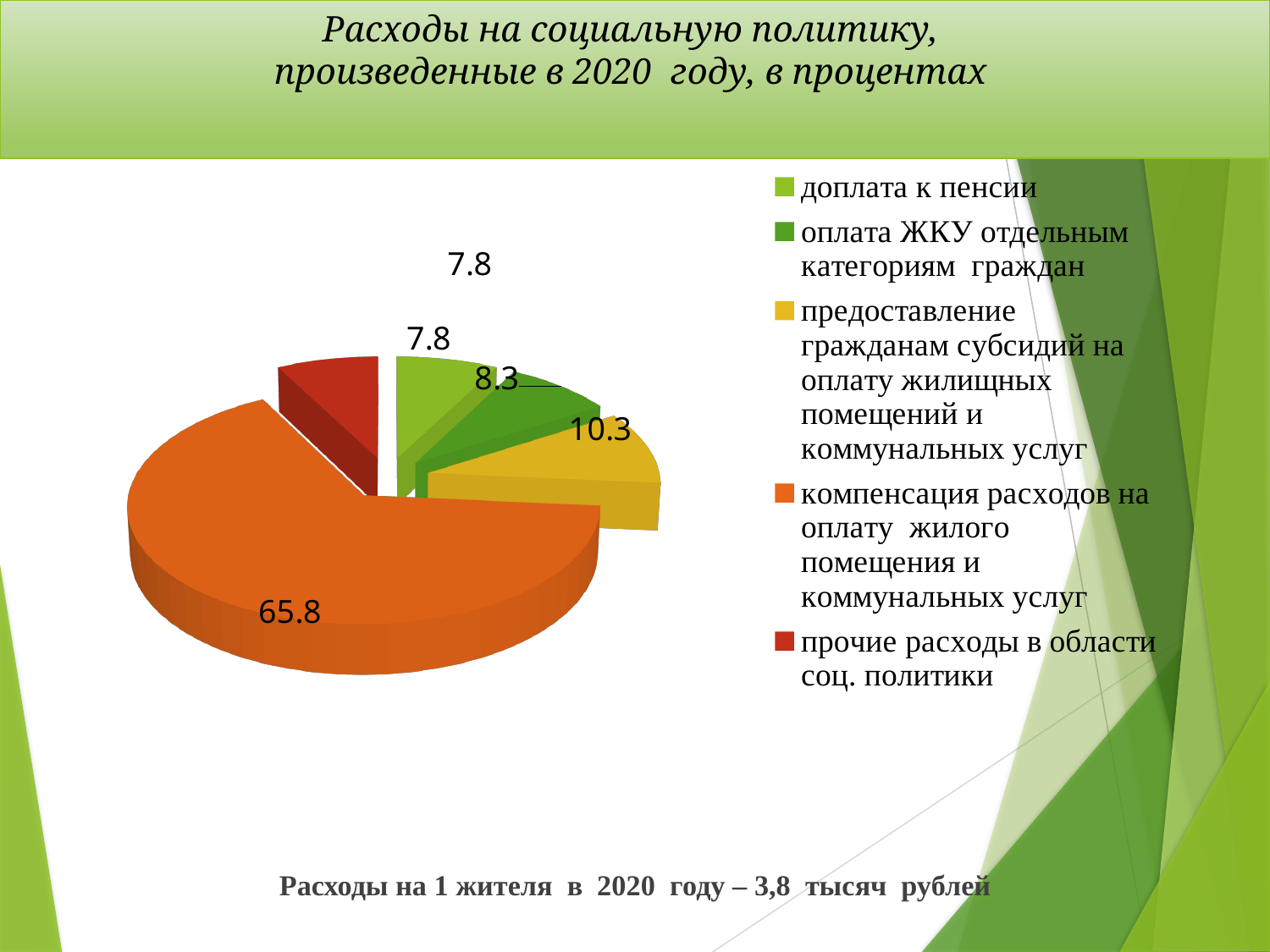
What kind of chart is shown on the slide? pie chart Which is larger: «предоставление гражданам субсидий на оплату жилищных помещений и коммунальных услуг» or «оплата ЖКУ отдельным категориям граждан»? предоставление гражданам субсидий на оплату жилищных помещений и коммунальных услуг How many slices does the pie chart have? 5 What is the value for «доплата к пенсии»? 7.8 What is the value for «прочие расходы в области соц. политики»? 7.8 What is the value for «оплата ЖКУ отдельным категориям граждан»? 8.3 What is the difference between the values for «компенсация расходов на оплату жилого помещения и коммунальных услуг» and «предоставление гражданам субсидий на оплату жилищных помещений и коммунальных услуг»? 55.5 What is the value for «предоставление гражданам субсидий на оплату жилищных помещений и коммунальных услуг»? 10.3 What is the value for «компенсация расходов на оплату жилого помещения и коммунальных услуг»? 65.8 Which category has the largest slice of the pie? компенсация расходов на оплату жилого помещения и коммунальных услуг How many entries does the legend list? 5 What colour is the largest slice of the pie? orange